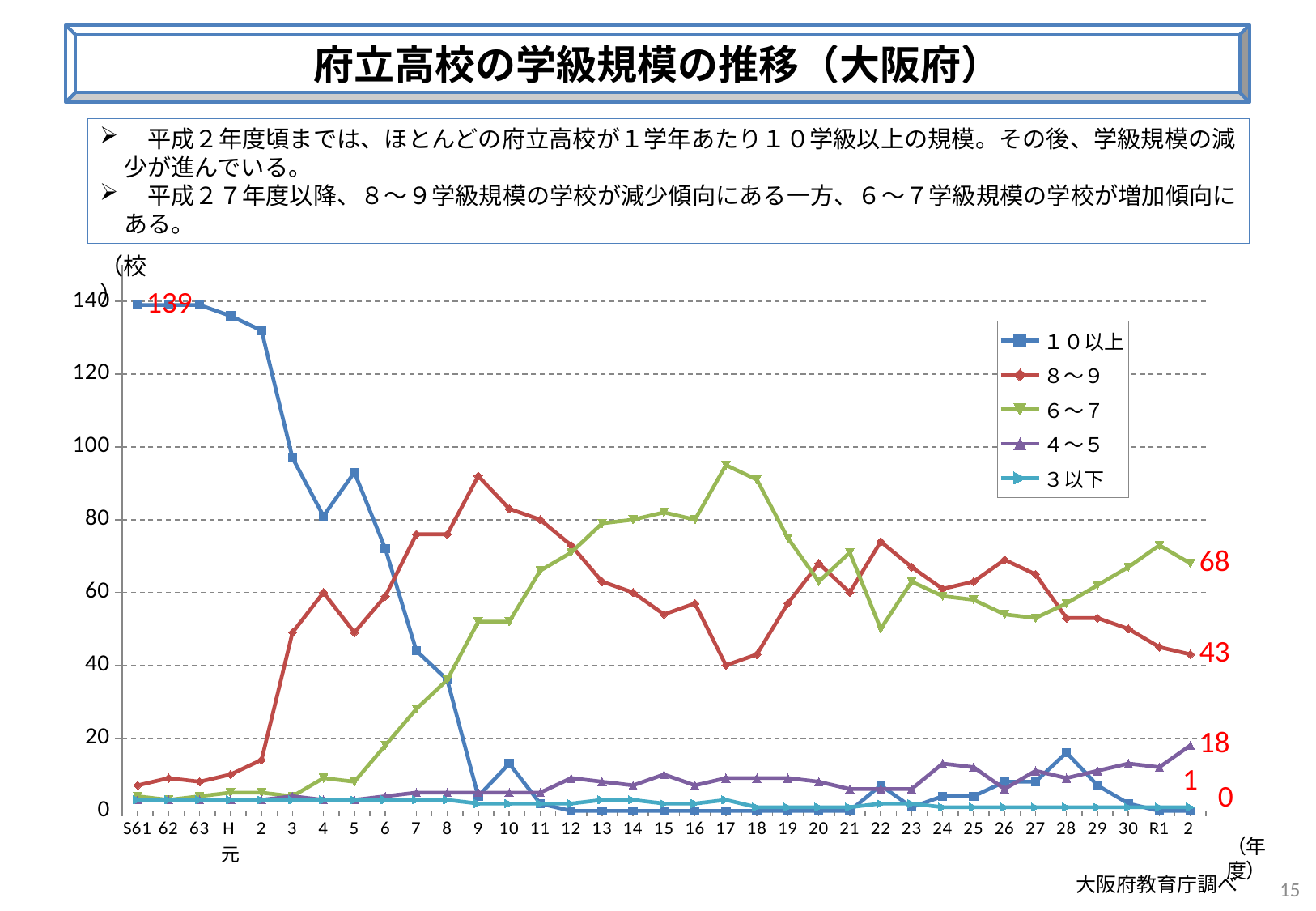
Which series has the highest value at S61? 10以上 Is the value of the 6～7 series at H17 greater or less than 80? greater What is the value of the 6～7 series at the final year (R2)? 68 At the final year (R2), what is the difference between the 6～7 series and the 8～9 series? 25 What is the value of the 10以上 series at S61? 139 Does the 10以上 series rise or fall over the period shown? fall What is the value of the 4～5 series at the final year (R2)? 18 At the final year (R2), which is larger: the 6～7 series or the 8～9 series? 6～7 Is the value of the 10以上 series at H2 greater or less than 120? greater How many series does the legend list? 5 What kind of chart is shown on the slide? line chart What is the value of the 8～9 series at the final year (R2)? 43